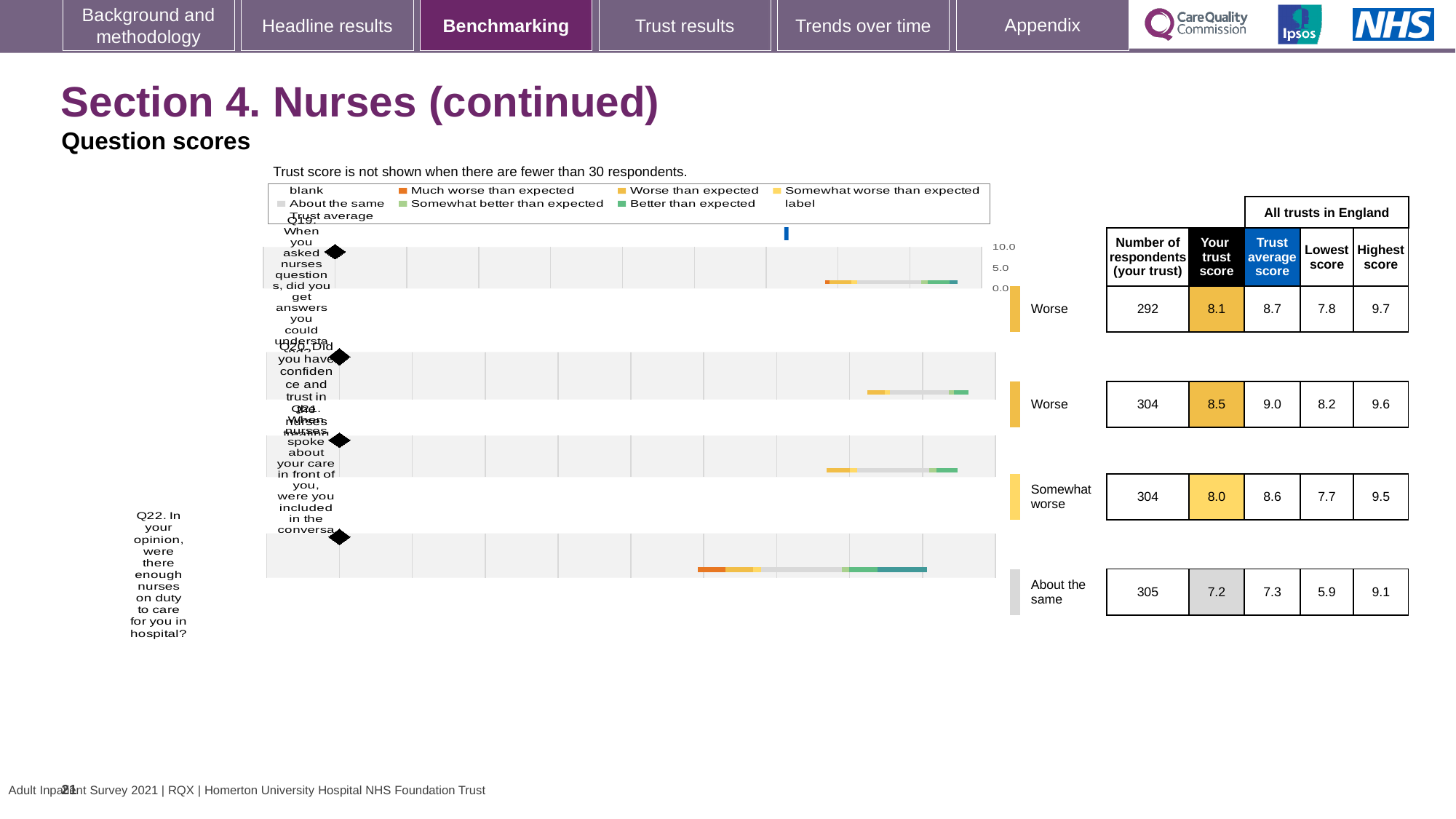
What is the highest score across all trusts in England for Q21 (were you included in the conversation)? 9.5 Which is larger: your trust score for Q20 or your trust score for Q22? Q20 What is the difference between the trust average score and your trust score for Q19? 0.6 Which question has the highest 'Your trust score' on this slide? Q20 How many questions are plotted in the chart? 4 What benchmark category is shown for Q22 (enough nurses on duty)? About the same What kind of chart is used to show the question scores? Bar chart What is the lowest score across all trusts in England for Q22? 5.9 How many respondents from your trust answered Q22 (were there enough nurses on duty)? 305 What is the 'Your trust score' for Q19 (When you asked nurses questions, did you get answers you could understand)? 8.1 What is the trust average score for Q20 (Did you have confidence and trust in the nurses)? 9.0 Which question has the lowest 'Your trust score' on this slide? Q22